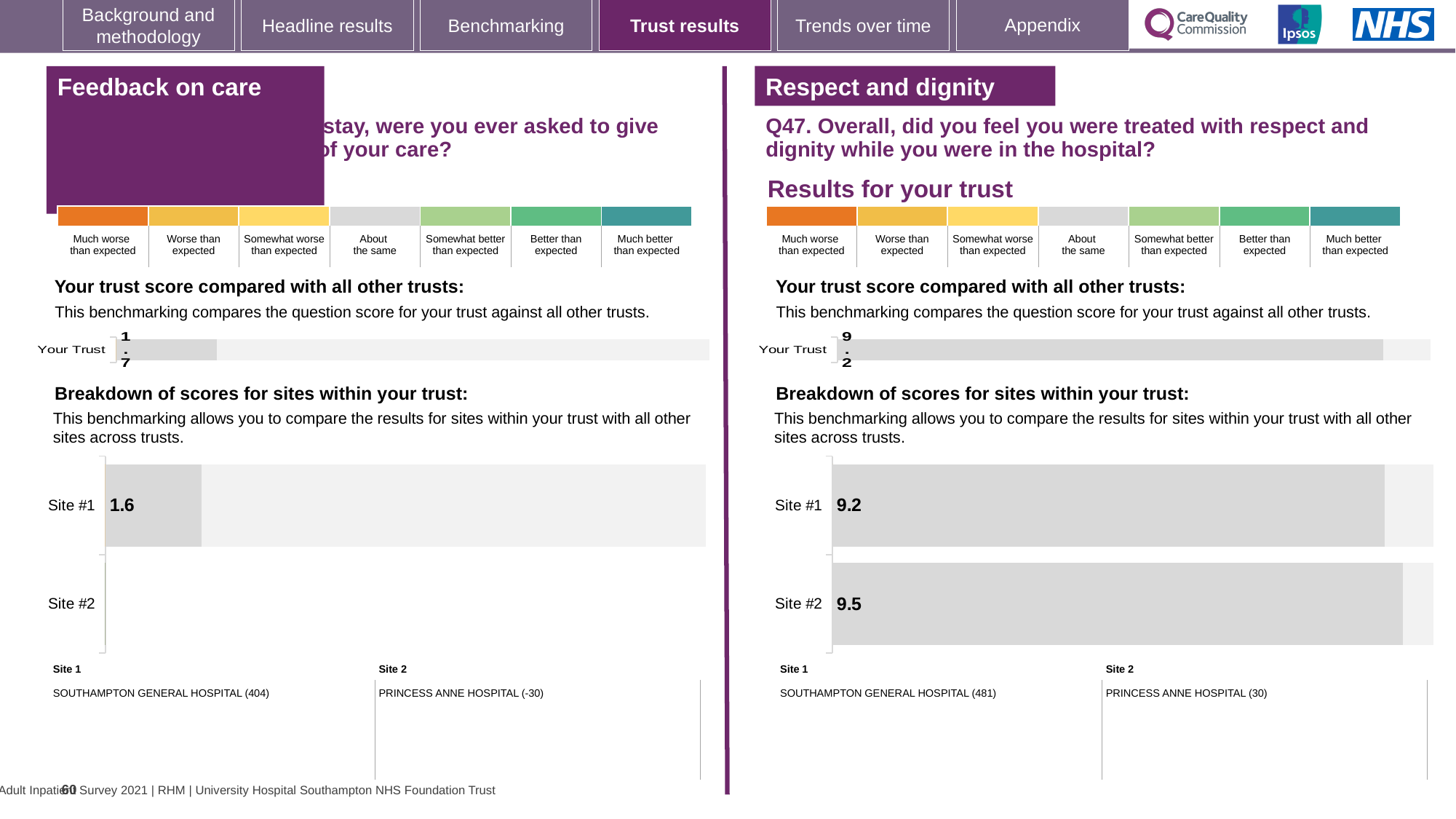
In the 'Respect and dignity' panel's 'Breakdown of scores for sites within your trust' chart, what is the score for Site #1? 9.2 In the 'Feedback on care' panel's 'Breakdown of scores for sites within your trust' chart, what is the score for Site #1? 1.6 In the 'Respect and dignity' panel, which hospital is listed as Site 2 below the breakdown chart? PRINCESS ANNE HOSPITAL (30) In the 'Respect and dignity' panel, what is the 'Your Trust' score shown in the 'Your trust score compared with all other trusts' chart? 9.2 In the 'Feedback on care' panel's 'Breakdown of scores for sites within your trust' chart, which site has a bar with a printed score? Site #1 In the 'Respect and dignity' panel's 'Breakdown of scores for sites within your trust' chart, which site has the higher score? Site #2 In the 'Feedback on care' panel, what is the 'Your Trust' score shown in the 'Your trust score compared with all other trusts' chart? 1.7 What kind of chart is used in the 'Breakdown of scores for sites within your trust' section of the 'Respect and dignity' panel? Bar chart Which is larger: the 'Your Trust' score in the 'Feedback on care' panel or the 'Your Trust' score in the 'Respect and dignity' panel? Respect and dignity In the 'Respect and dignity' panel's 'Breakdown of scores for sites within your trust' chart, what is the difference between the Site #2 and Site #1 scores? 0.3 In the 'Respect and dignity' panel's 'Breakdown of scores for sites within your trust' chart, what is the score for Site #2? 9.5 In the 'Respect and dignity' panel's 'Breakdown of scores for sites within your trust' chart, how many sites are listed? 2